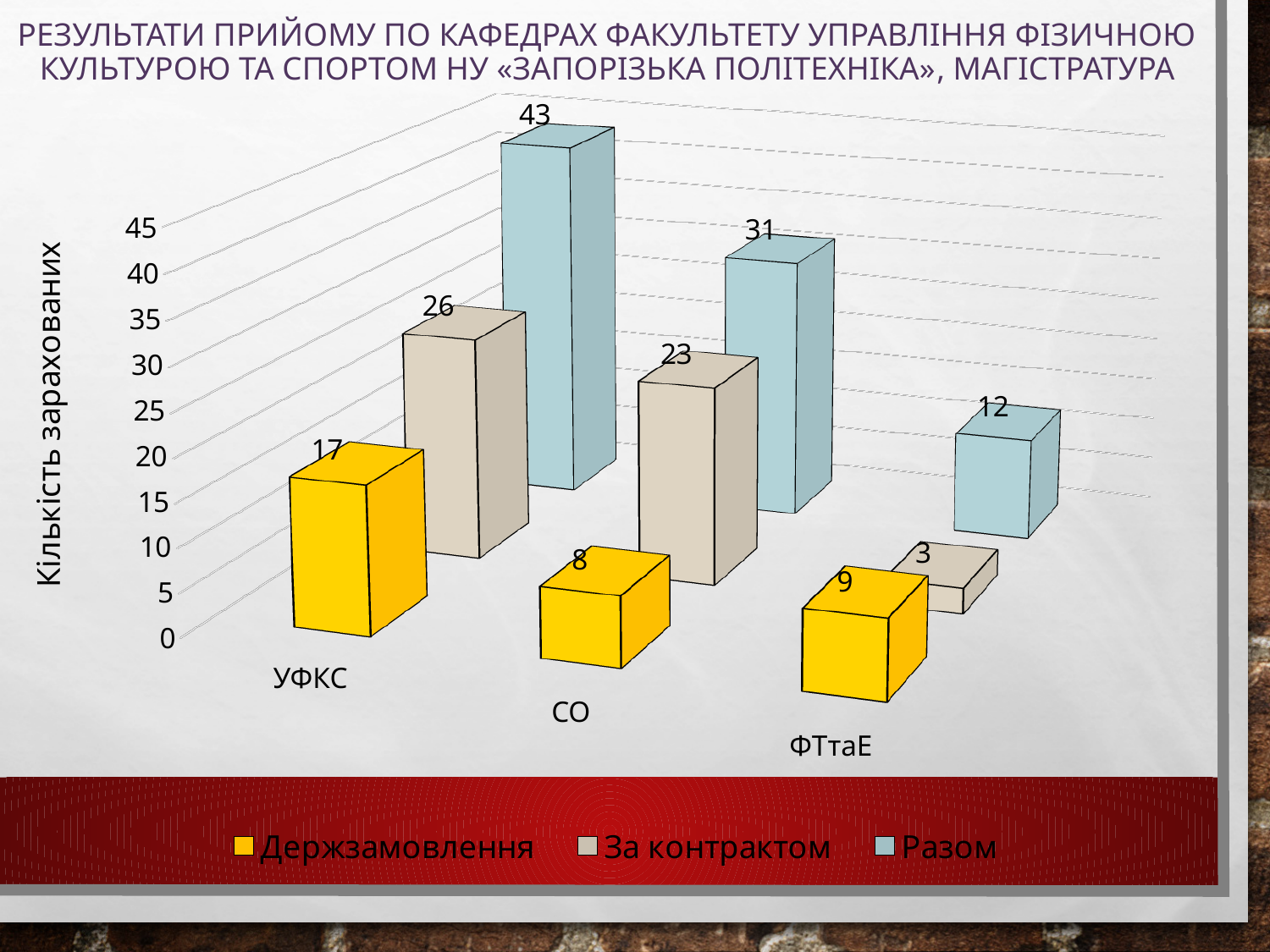
What is the value for Разом at ФТтаЕ? 12 Which category has the highest value for Разом? УФКС What is the value for За контрактом at ФТтаЕ? 3 What is the value for За контрактом at СО? 23 What is the difference between the Разом values for УФКС and СО? 12 How many categories are shown on the x axis? 3 Which is larger: Держзамовлення at СО or Держзамовлення at ФТтаЕ? Держзамовлення at ФТтаЕ What is the label of the vertical axis? Кількість зарахованих How many series does the legend list? 3 What kind of chart is shown on the slide? bar chart Which category has the lowest value for За контрактом? ФТтаЕ What is the value for Держзамовлення at УФКС? 17